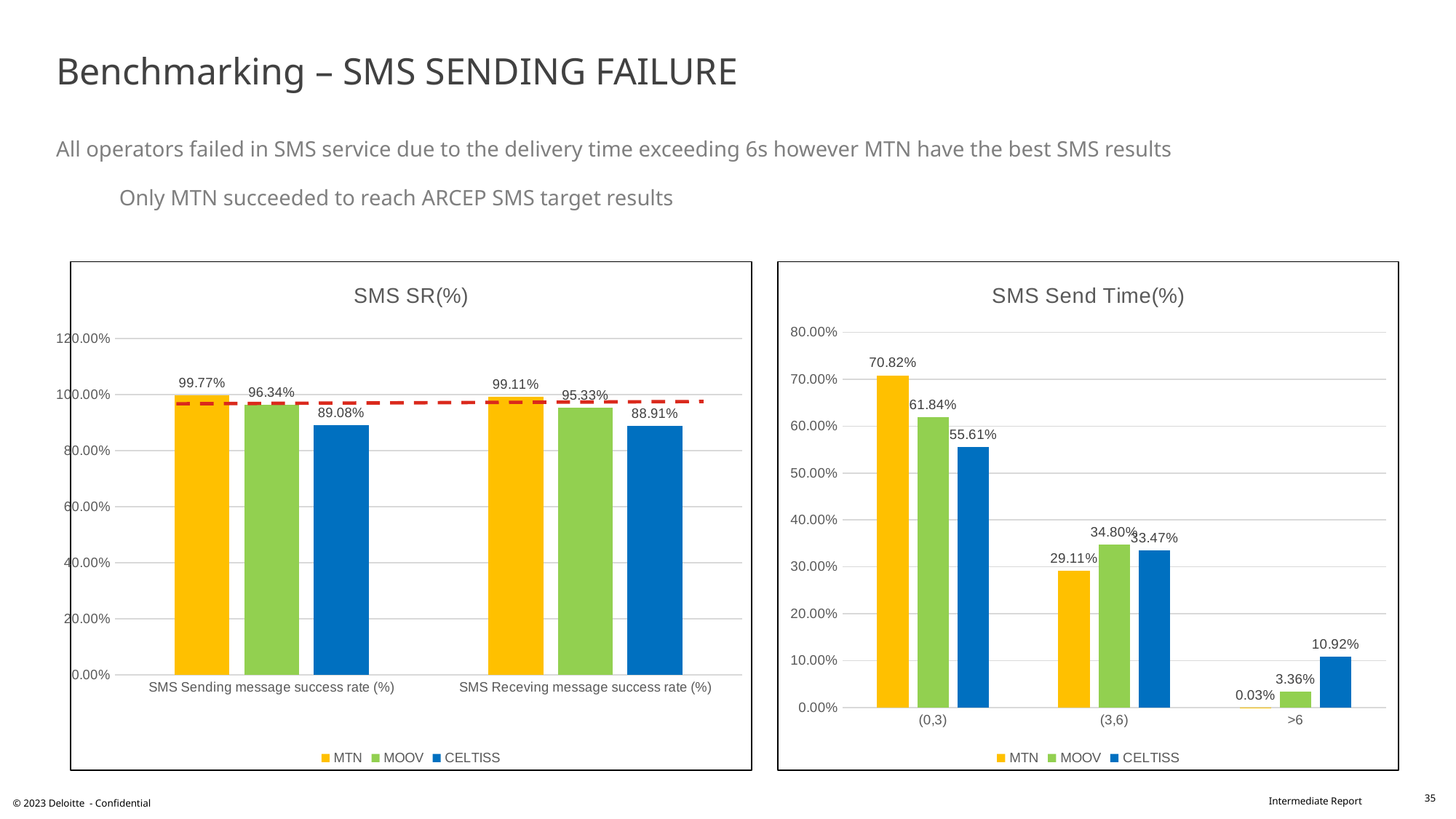
In the SMS Send Time(%) chart, what is the difference between MTN and CELTISS in the (0,3) category? 15.21% In the SMS Send Time(%) chart, what is the value for CELTISS in the >6 category? 10.92% In the SMS SR(%) chart, how many series does the legend list? 3 In the SMS SR(%) chart, what is the difference between MTN and MOOV for SMS Receving message success rate (%)? 3.78% In the SMS Send Time(%) chart, which is larger in the (3,6) category: MTN or CELTISS? CELTISS In the SMS SR(%) chart, what is the value for CELTISS for SMS Receving message success rate (%)? 88.91% What kind of chart is the SMS Send Time(%) chart? Bar chart In the SMS Send Time(%) chart, what is the value for MOOV in the (3,6) category? 34.80% In the SMS Send Time(%) chart, how many categories are shown on the x axis? 3 In the SMS Send Time(%) chart, which operator has the highest value in the (0,3) category? MTN In the SMS SR(%) chart, which operator has the lowest SMS Sending message success rate (%)? CELTISS In the SMS SR(%) chart, what is the value for MTN for SMS Sending message success rate (%)? 99.77%